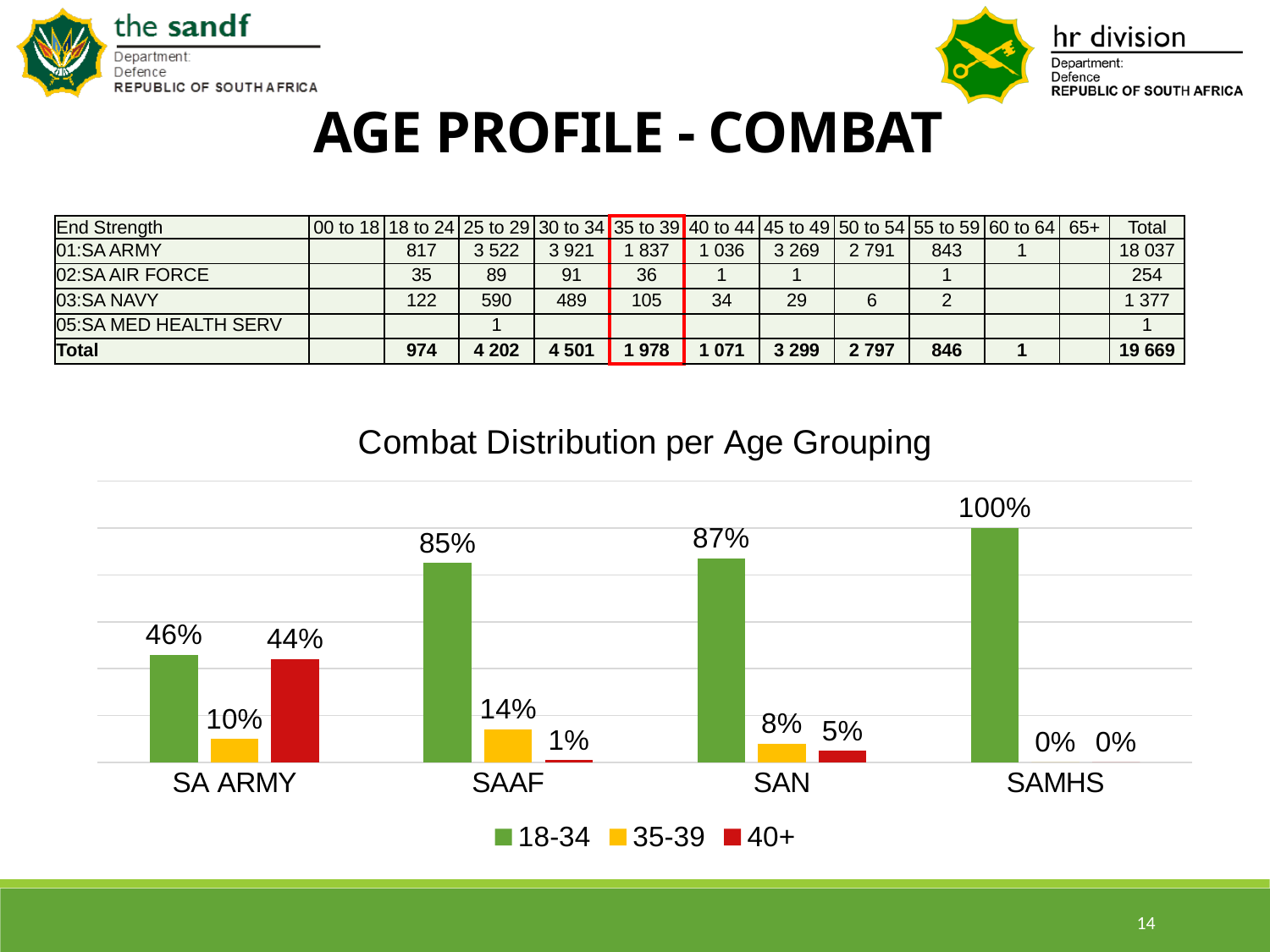
What is the value for the 40+ series for SAAF? 1% Which category has the lowest value for the 40+ series? SAMHS What is the title of the chart? Combat Distribution per Age Grouping How many categories are shown on the x axis of the chart? 4 What is the value for the 35-39 series for SAAF? 14% What is the difference between the 18-34 and 40+ values for SA ARMY? 2% What is the value for the 40+ series for SAN? 5% Which is larger for SAN: the 35-39 value or the 40+ value? 35-39 Which category has the highest value for the 18-34 series? SAMHS How many series does the chart legend list? 3 What kind of chart is shown on the slide? bar chart What is the value for the 18-34 series for SA ARMY? 46%